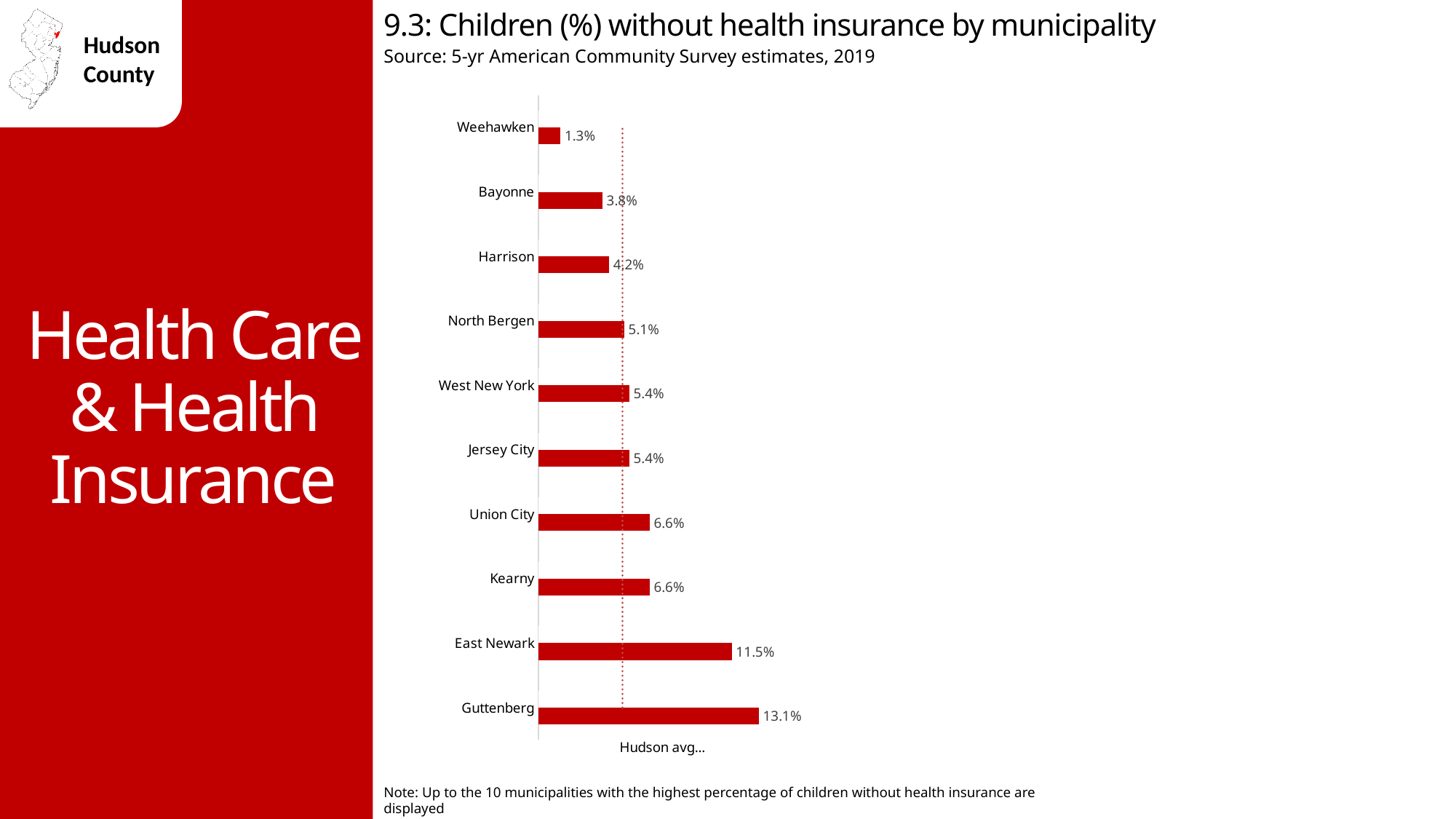
What is the source of the data shown in the chart? 5-yr American Community Survey estimates, 2019 What percentage is shown for Weehawken? 1.3% What type of chart is shown on the slide? Bar chart How many municipalities are shown in the chart? 10 What is the difference between the values for Guttenberg and East Newark? 1.6% What is the value for North Bergen? 5.1% What is the difference between the values for Union City and Bayonne? 2.8% What percentage of children in Guttenberg are without health insurance? 13.1% Which municipality has the highest percentage of children without health insurance? Guttenberg What is the value shown for East Newark? 11.5% Which has a higher value, Harrison or Kearny? Kearny Which municipality has the lowest percentage of children without health insurance? Weehawken